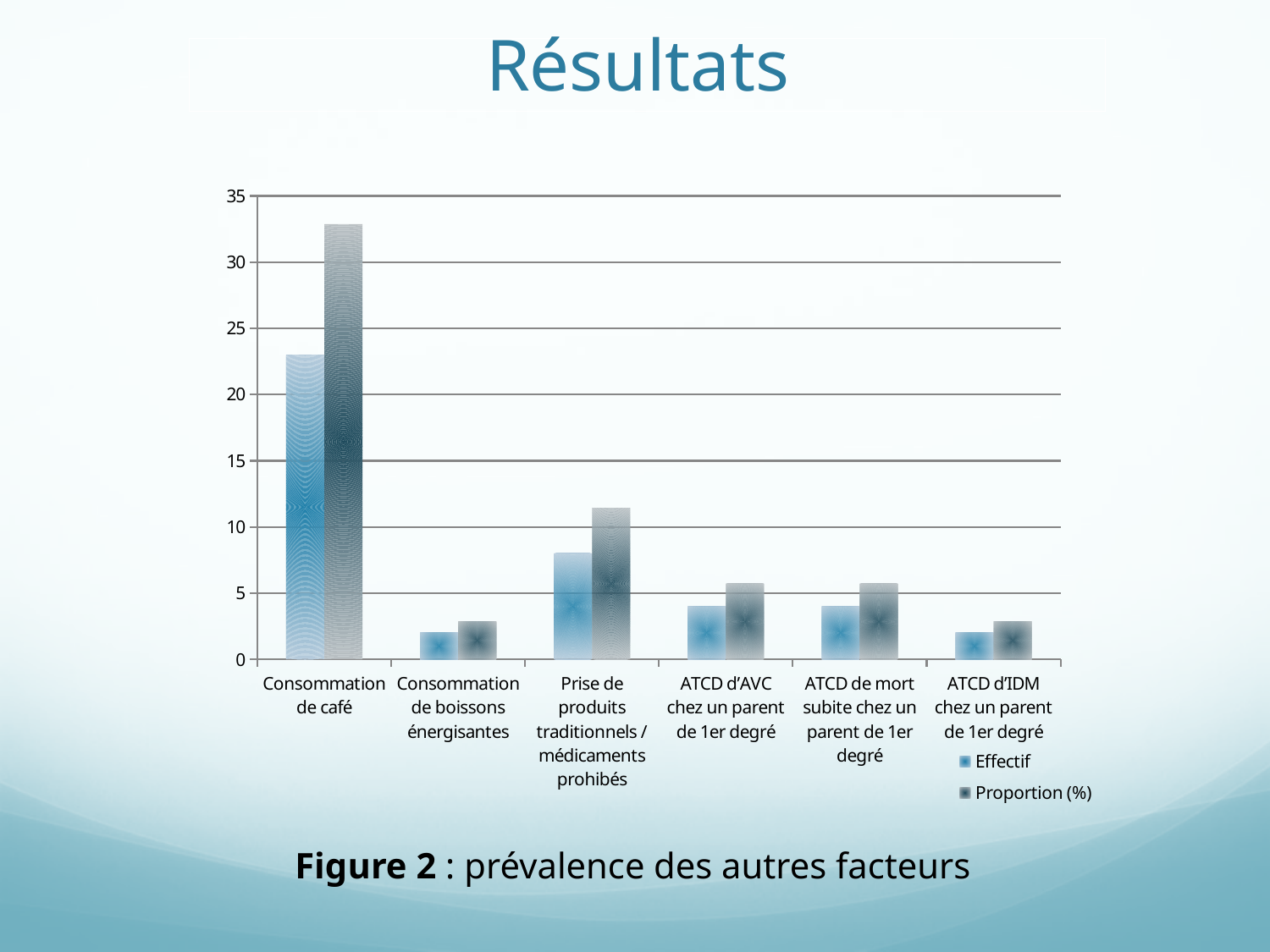
What are the two series named in the chart's legend? Effectif and Proportion (%) How many series does the chart's legend list? 2 Which category has the highest Proportion (%) value? Consommation de café Which category has the highest Effectif value? Consommation de café How many categories are shown on the x axis of the chart? 6 Which has the larger Effectif value: Prise de produits traditionnels / médicaments prohibés or ATCD d'IDM chez un parent de 1er degré? Prise de produits traditionnels / médicaments prohibés Is the Proportion (%) value for Prise de produits traditionnels / médicaments prohibés greater or less than 10? greater What kind of chart is shown on the slide? bar chart Is the Effectif value for Consommation de café greater or less than 20? greater Is the Effectif value for ATCD d'AVC chez un parent de 1er degré greater or less than 5? less What is the caption given for the figure below the chart? Figure 2 : prévalence des autres facteurs